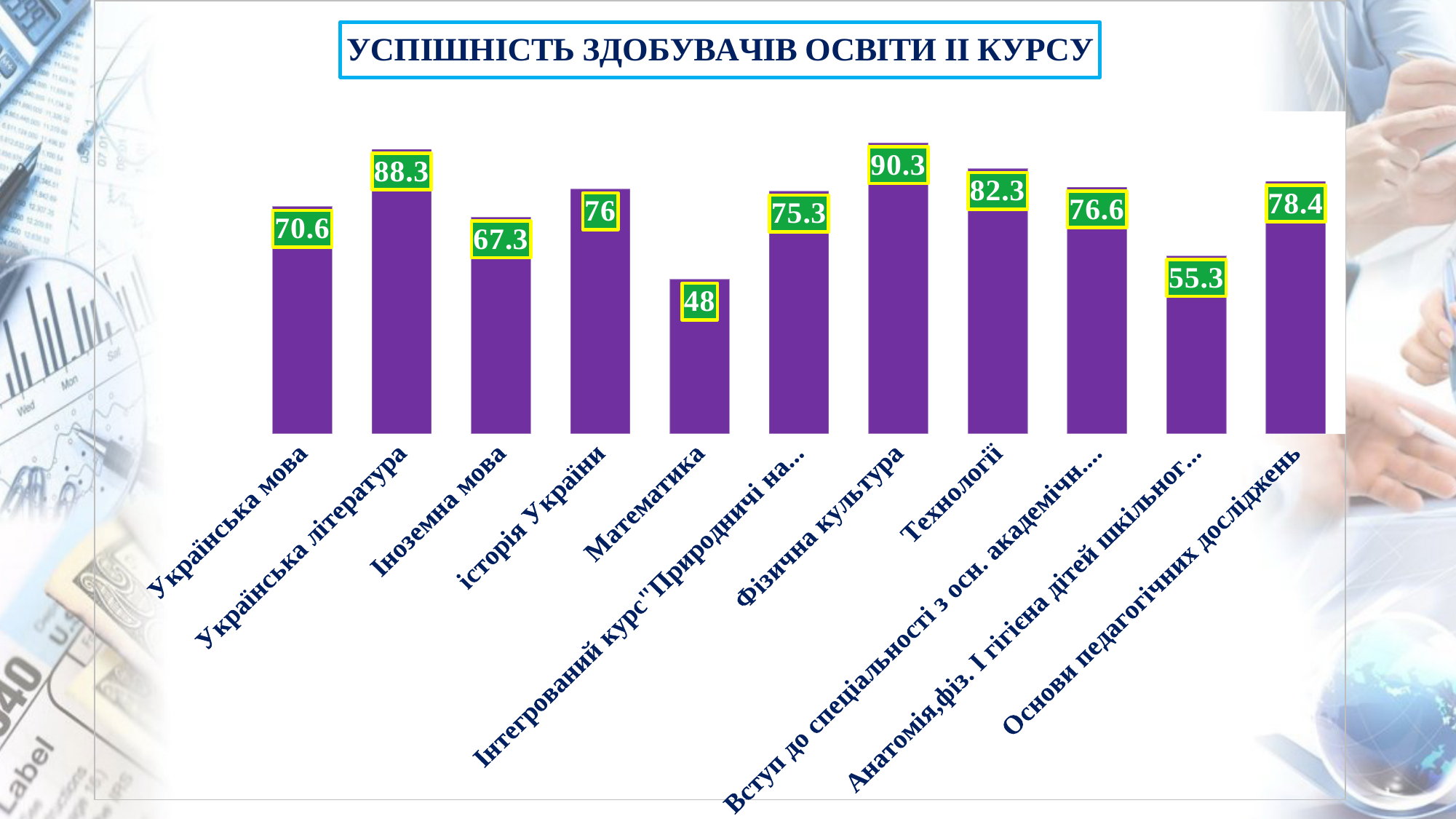
What kind of chart is shown on the slide? Bar chart What is the title of the slide? УСПІШНІСТЬ ЗДОБУВАЧІВ ОСВІТИ ІІ КУРСУ Which category has the highest value? Фізична культура What is the value for Фізична культура? 90.3 Which is larger, the value for Українська мова or the value for історія України? історія України How many categories are shown in the chart? 11 Which category has the lowest value? Математика What is the value for Українська література? 88.3 What colour are the bars in the chart? Purple What is the value for Основи педагогічних досліджень? 78.4 What is the difference between the values for Технології and Іноземна мова? 15 What is the value for Математика? 48